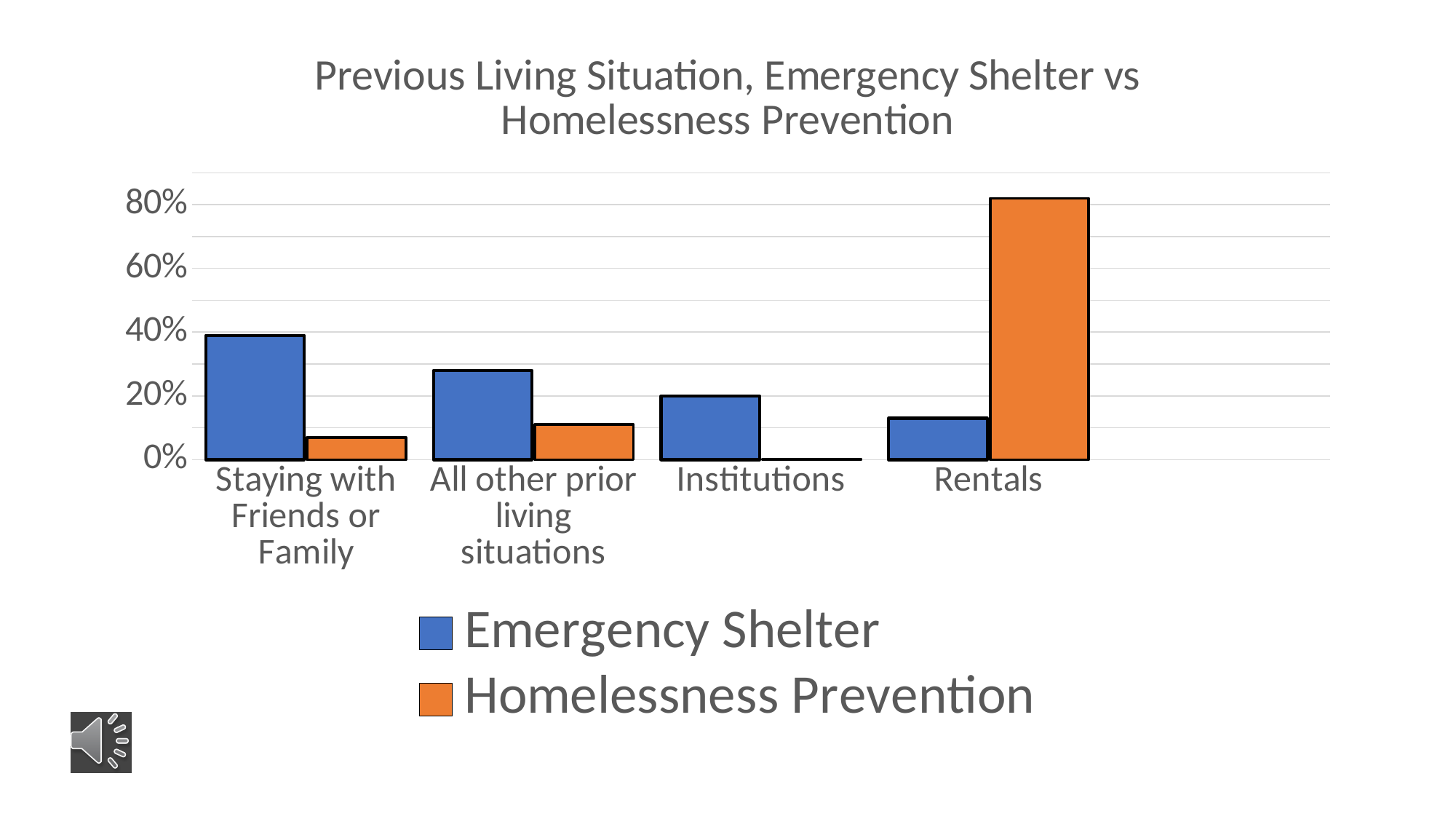
What kind of chart is shown on the slide? bar chart What is the title of the chart? Previous Living Situation, Emergency Shelter vs Homelessness Prevention How many series does the legend list? 2 How many categories are shown on the x axis? 4 Which category has the lowest value for Homelessness Prevention? Institutions Which category has the lowest value for Emergency Shelter? Rentals Is the Emergency Shelter value for Staying with Friends or Family greater or less than 20%? greater Which category has the highest value for Emergency Shelter? Staying with Friends or Family For Staying with Friends or Family, which series has the larger value, Emergency Shelter or Homelessness Prevention? Emergency Shelter Is the Homelessness Prevention value for Rentals greater or less than 60%? greater Which category has the highest value for Homelessness Prevention? Rentals For Rentals, which series has the larger value, Emergency Shelter or Homelessness Prevention? Homelessness Prevention